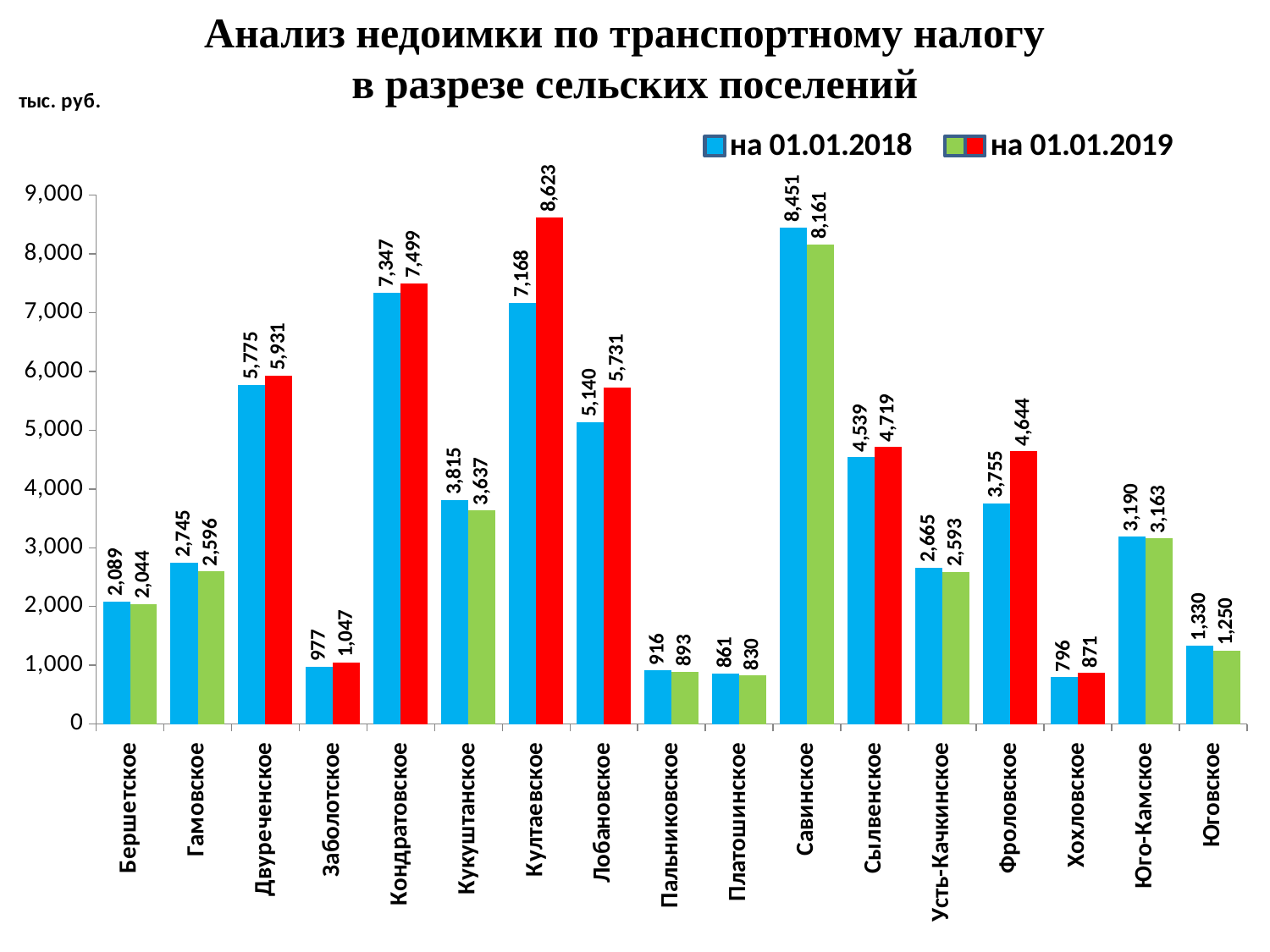
What is the value for Култаевское на 01.01.2019? 8,623 Which settlement has the lowest value на 01.01.2019? Платошинское What is the value for Хохловское на 01.01.2019? 871 How many series does the legend list? 2 What is the difference between the 01.01.2019 and 01.01.2018 values for Фроловское? 889 Which settlement has the highest value на 01.01.2018? Савинское By how much did the value for Култаевское change from 01.01.2018 to 01.01.2019? 1,455 Which settlement has the lowest value на 01.01.2018? Хохловское What is the value for Савинское на 01.01.2018? 8,451 How many settlements are shown on the x axis? 17 Which is larger for Кукуштанское: the value на 01.01.2018 or на 01.01.2019? на 01.01.2018 Which settlement has the highest value на 01.01.2019? Култаевское